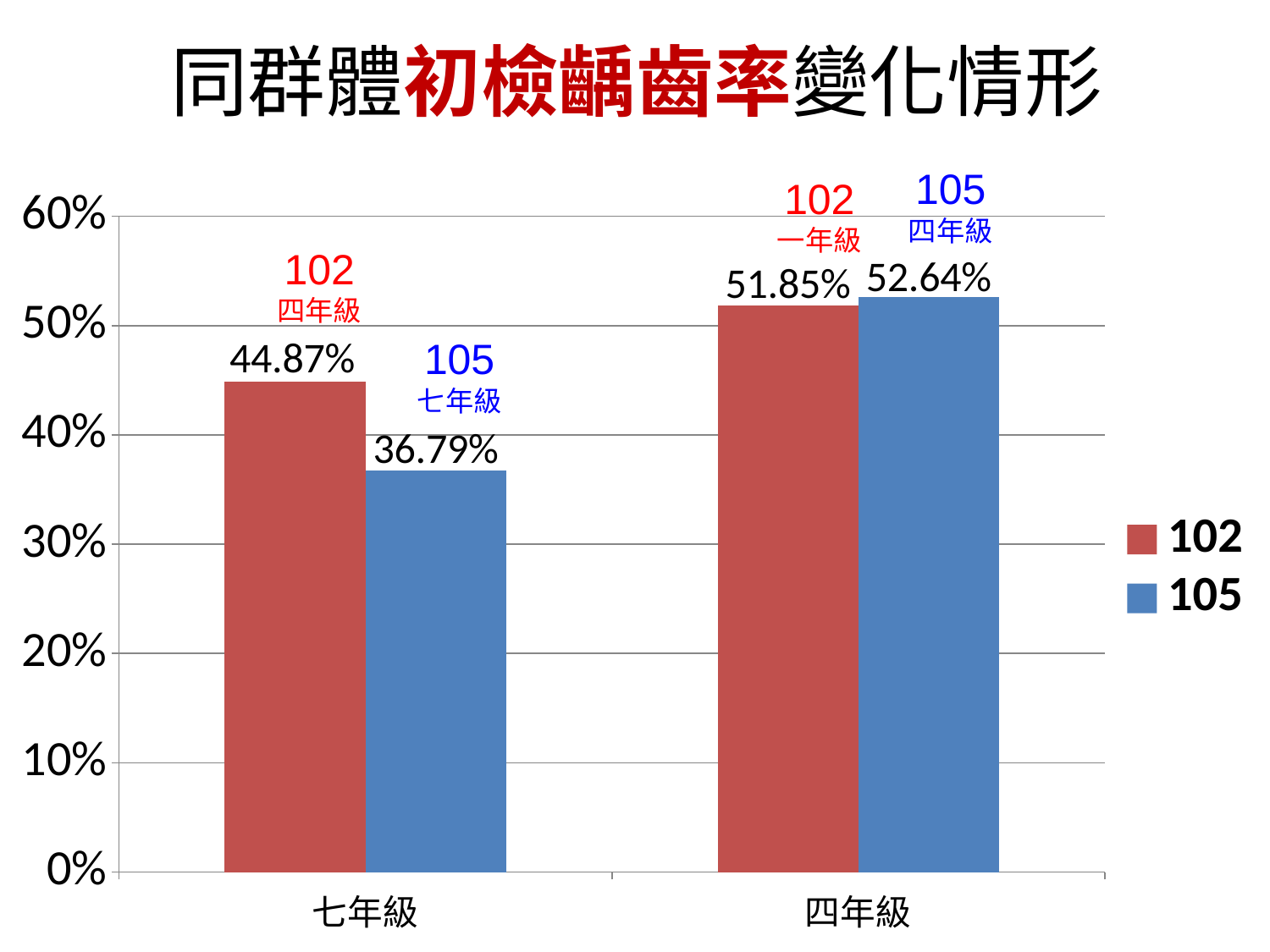
Which bar has the highest value on the chart? 105 for 四年級 What is the difference between the 102 and 105 values for 七年級? 8.08% For 七年級, which series has the larger value, 102 or 105? 102 What is the value of the 102 series for 四年級? 51.85% What is the difference between the 105 and 102 values for 四年級? 0.79% Is the 102 value for 七年級 greater or less than 40%? greater What kind of chart is shown on the slide? bar chart What is the value of the 105 series for 七年級? 36.79% Which bar has the lowest value on the chart? 105 for 七年級 What is the value of the 105 series for 四年級? 52.64% What is the value of the 102 series for 七年級? 44.87% How many series does the legend list? 2